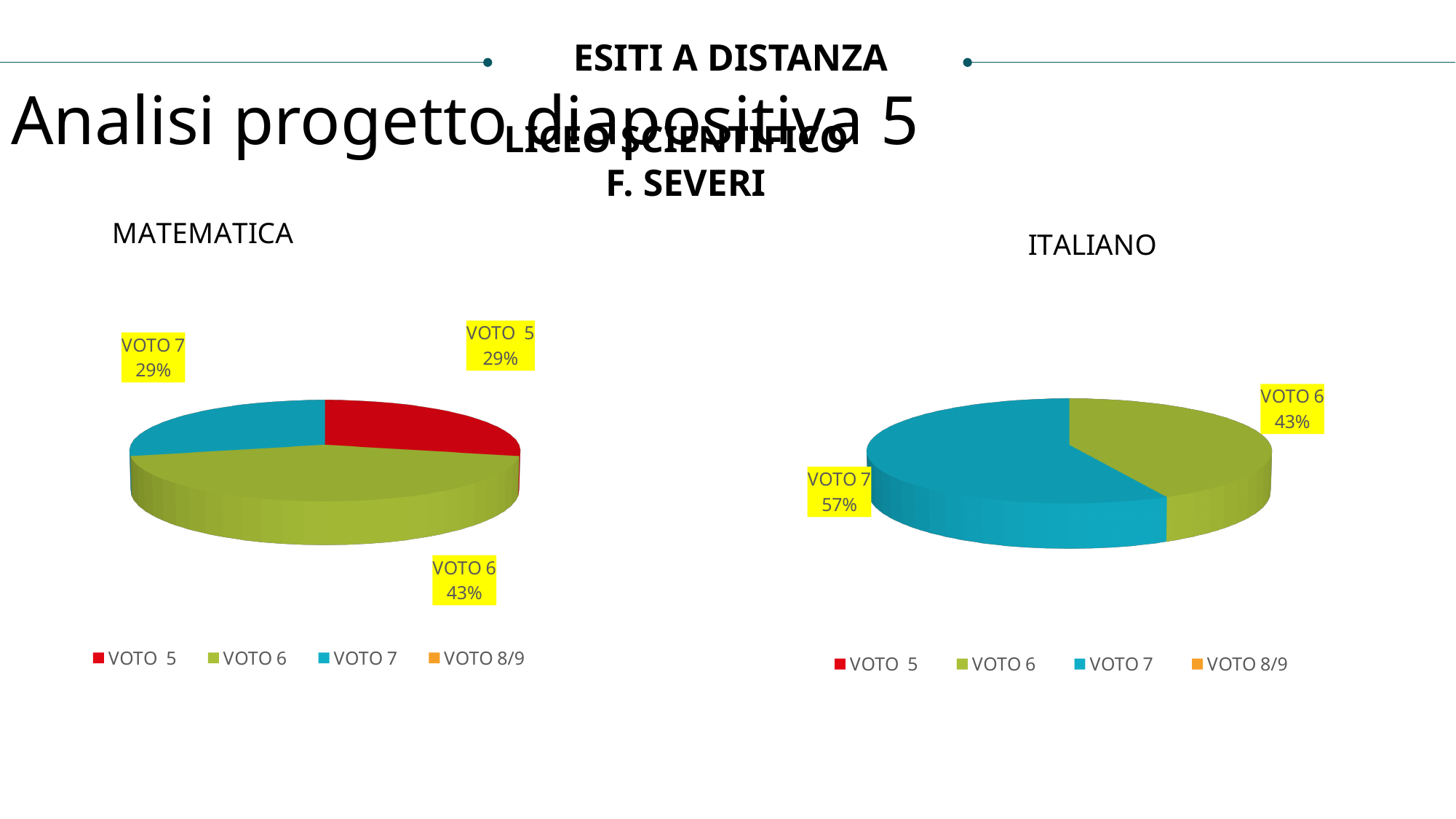
In the ITALIANO chart, which category has the largest slice? VOTO 7 In the ITALIANO chart, what share of the pie is VOTO 7? 57% In the ITALIANO chart, which category has the smallest slice? VOTO 6 What kind of chart is the ITALIANO chart? Pie chart How many entries does the legend of the MATEMATICA chart list? 4 In the MATEMATICA chart, what is the difference between the VOTO 6 and VOTO 5 shares? 14% In the MATEMATICA chart, which category has the largest slice? VOTO 6 In the MATEMATICA chart, what share of the pie is VOTO 5? 29% In the MATEMATICA chart, what share of the pie is VOTO 7? 29% In the ITALIANO chart, what is the difference between the VOTO 7 and VOTO 6 shares? 14%